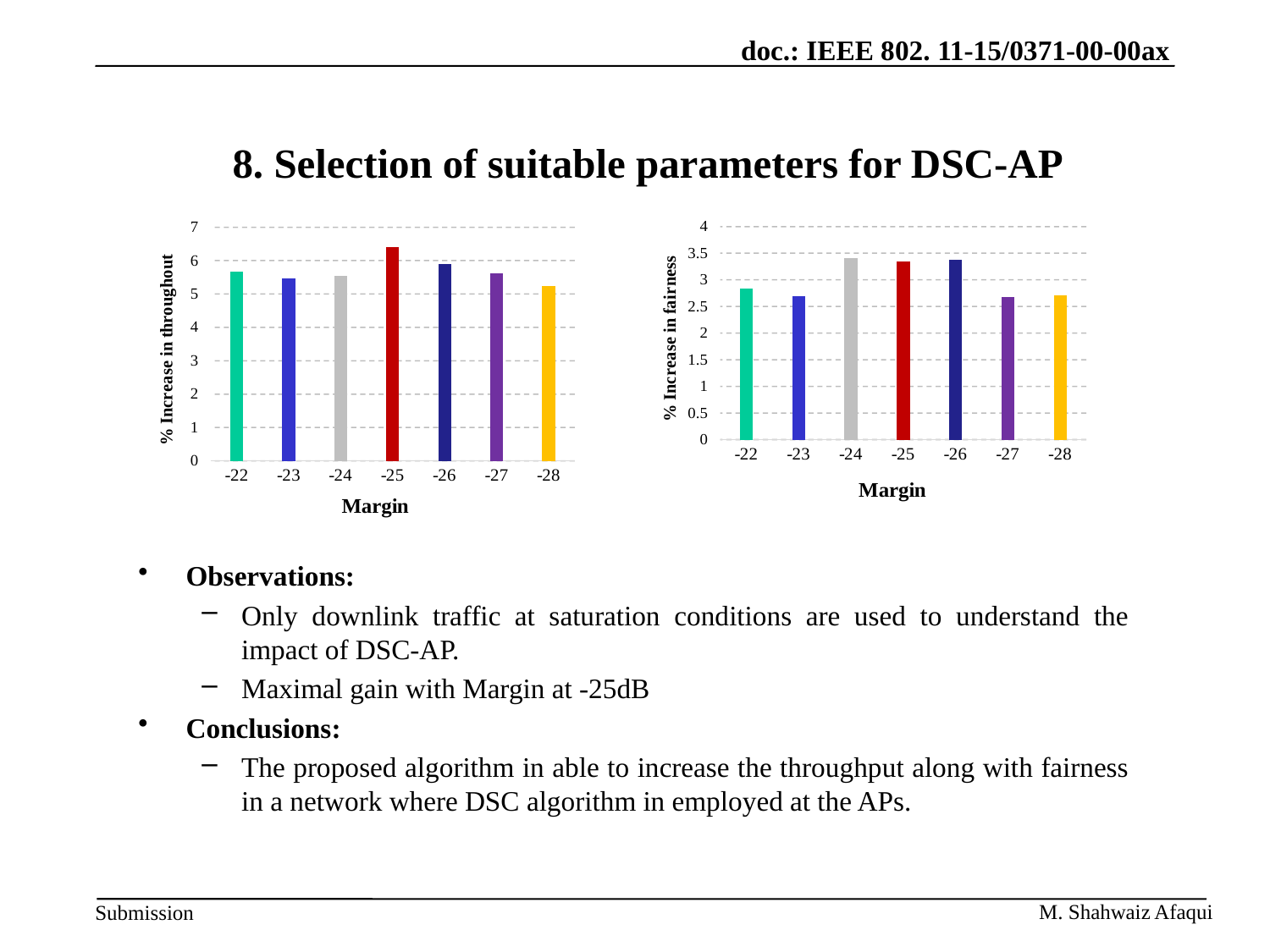
On the right chart (% Increase in fairness), is the value for Margin -23 greater or less than 3? less On the right chart (% Increase in fairness), which is larger, the value for Margin -25 or Margin -27? -25 On the left chart (% Increase in throughput), which is larger, the value for Margin -25 or Margin -23? -25 On the right chart (% Increase in fairness), is the value for Margin -24 greater or less than 3? greater On the left chart (% Increase in throughput), which Margin value has the highest bar? -25 What is the x-axis title of the left chart? Margin On the right chart (% Increase in fairness), how many Margin categories are plotted? 7 On the left chart (% Increase in throughput), is the value for Margin -28 greater or less than 5? greater What kind of chart is the right chart (% Increase in fairness)? bar chart On the left chart (% Increase in throughput), how many Margin categories are plotted? 7 On the left chart (% Increase in throughput), which Margin value has the lowest bar? -28